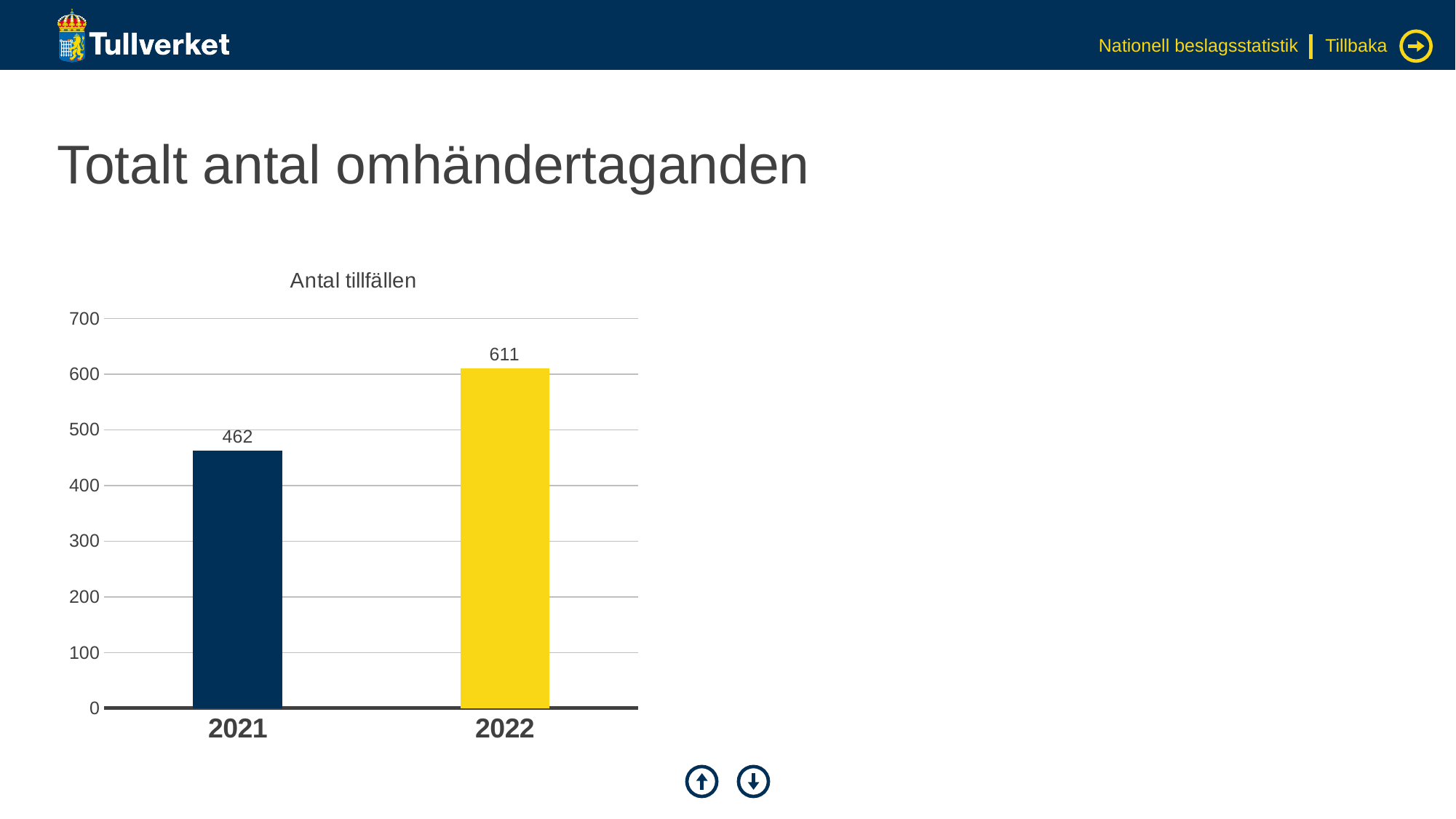
Do the values rise or fall from 2021 to 2022? rise Is the value for 2022 greater or less than 600? greater How many categories are shown on the x axis? 2 What is the title of the chart? Antal tillfällen What is the value for 2021? 462 What is the value for 2022? 611 Is the value for 2021 greater or less than 500? less What kind of chart is shown on the slide? bar chart Which year has the lowest value? 2021 What is the difference between the values for 2022 and 2021? 149 Which year has the highest value? 2022 Which is larger, the value for 2021 or the value for 2022? 2022